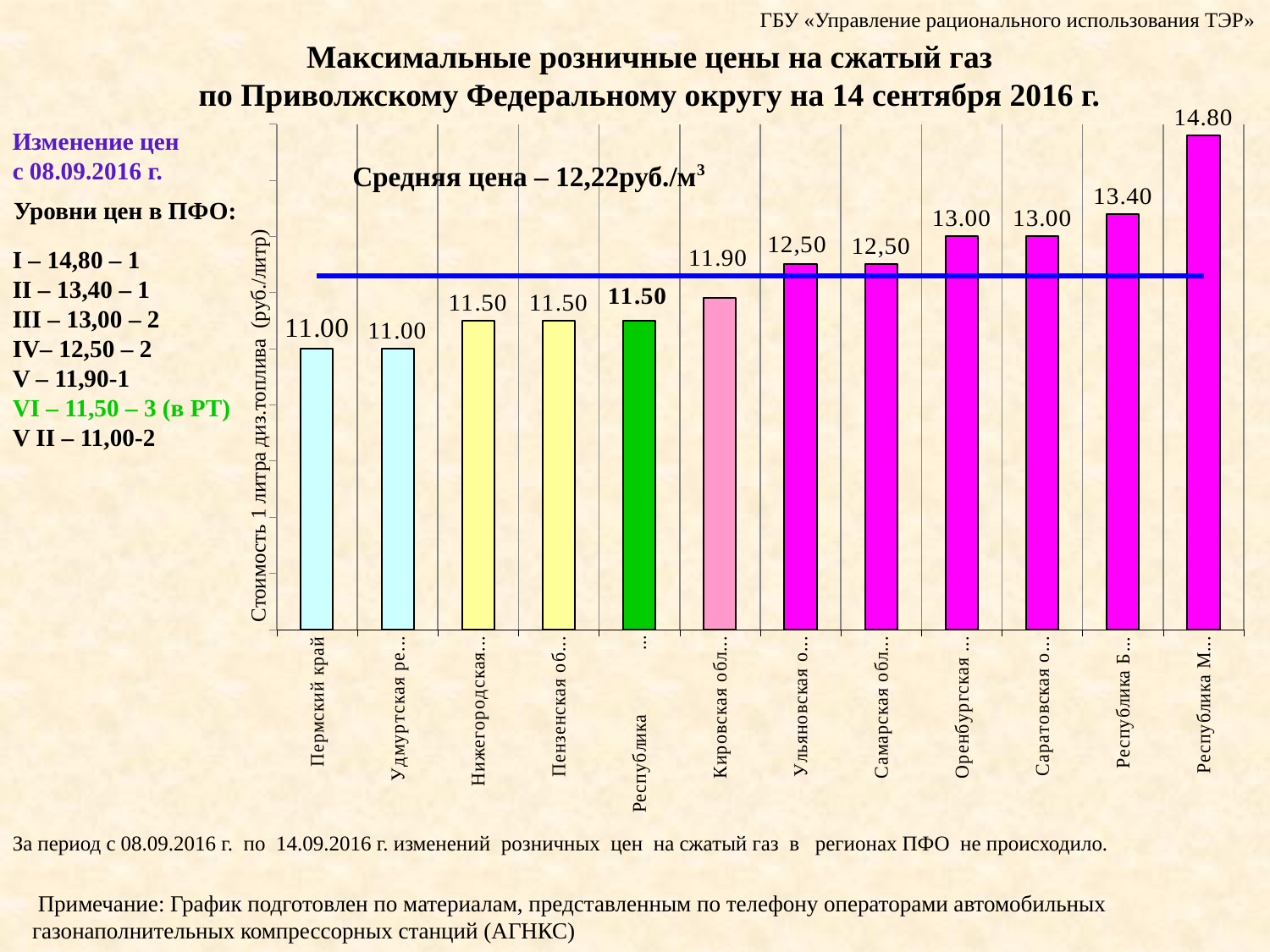
Which has the larger value, Кировская обл. or Пензенская обл.? Кировская обл. What is the value shown for Кировская обл.? 11.90 How many bars are plotted on the chart? 12 What kind of chart is shown on the slide? bar chart What average price (Средняя цена) is stated on the chart? 12,22 руб./м³ What is the difference between the values for Саратовская обл. and Пермский край? 2.00 Do the bar values rise or fall from left to right along the x axis? rise What is the value shown for Оренбургская обл.? 13.00 What is the highest value shown on the chart? 14.80 What is the value shown for Пермский край? 11.00 What is the value shown for Ульяновская обл.? 12,50 What is the lowest value shown on the chart? 11.00